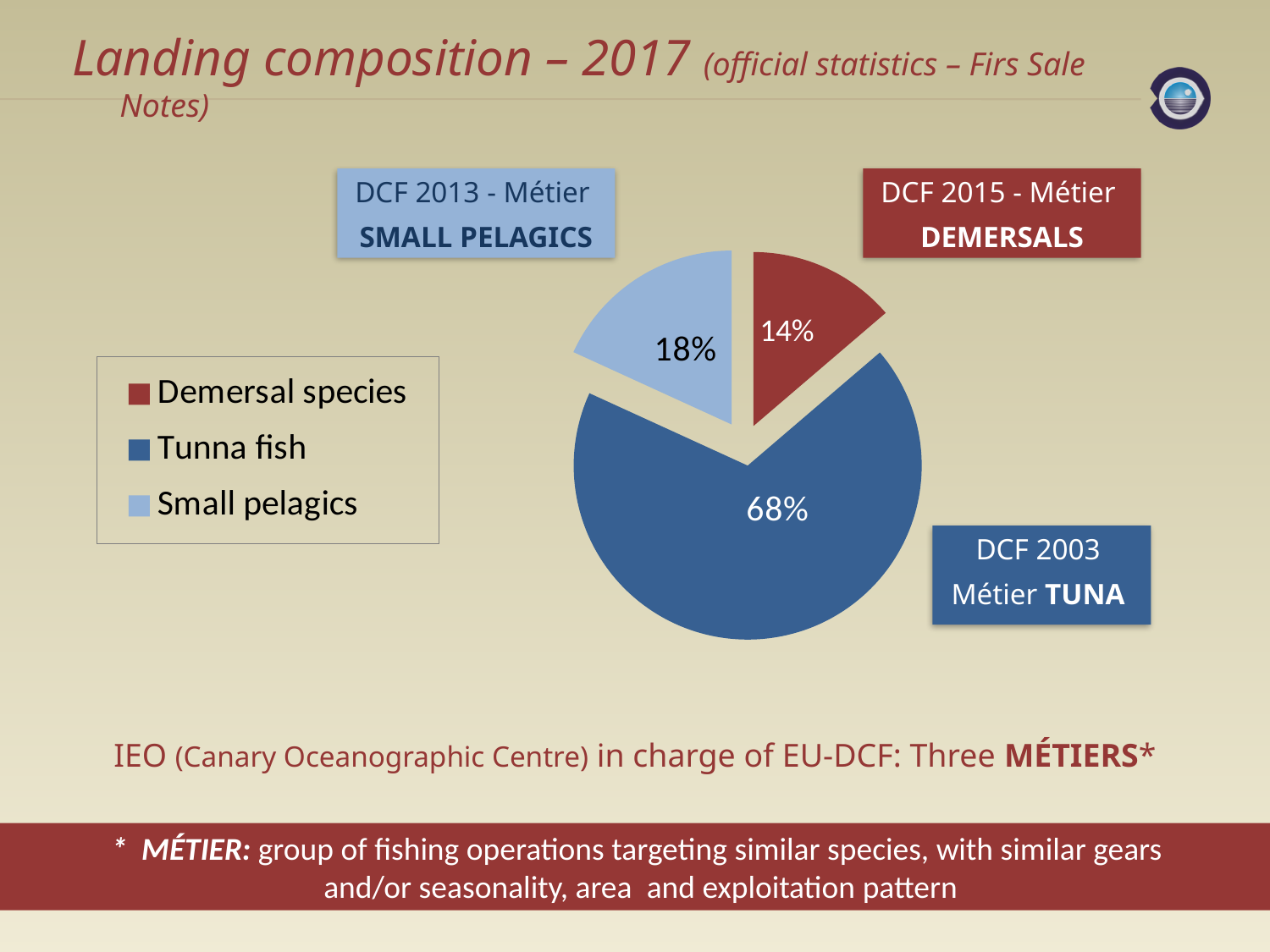
What share of the pie does Small pelagics account for? 18% What kind of chart is shown on the slide? pie chart How many categories does the pie chart have? 3 Which is larger, the Small pelagics slice or the Demersal species slice? Small pelagics What share of the pie does Tunna fish account for? 68% What is the difference in percentage points between the Small pelagics slice and the Demersal species slice? 4 What share of the pie does Demersal species account for? 14% What is the difference in percentage points between the Tunna fish slice and the Small pelagics slice? 50 How many entries does the legend list? 3 Which category has the smallest slice of the pie? Demersal species What colour is the Small pelagics slice in the pie chart? light blue Which category has the largest slice of the pie? Tunna fish